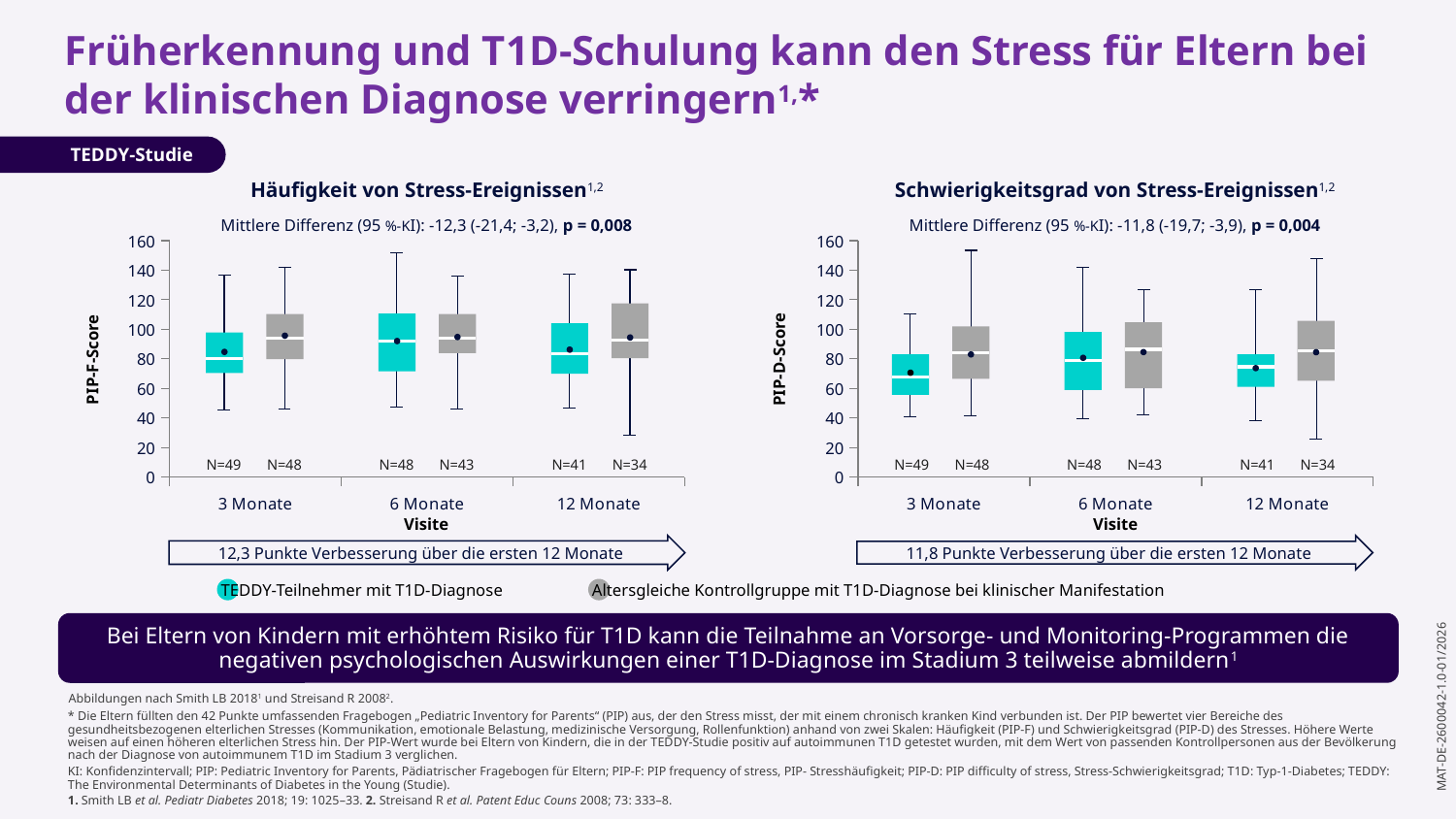
In the right chart 'Schwierigkeitsgrad von Stress-Ereignissen', what p-value is reported? p = 0,004 In the left chart 'Häufigkeit von Stress-Ereignissen', is the upper whisker of the Kontrollgruppe at 12 Monate greater or less than 120? greater In the left chart 'Häufigkeit von Stress-Ereignissen', what is the mean difference (Mittlere Differenz) with its 95% CI? -12,3 (-21,4; -3,2) In the right chart 'Schwierigkeitsgrad von Stress-Ereignissen', at 3 Monate, which group has the higher median PIP-D-Score: TEDDY-Teilnehmer or the Kontrollgruppe? Kontrollgruppe What kind of chart is used in the left chart, 'Häufigkeit von Stress-Ereignissen'? Box plot In the right chart 'Schwierigkeitsgrad von Stress-Ereignissen', what is the N for the TEDDY-Teilnehmer group at 6 Monate? N=48 In the left chart 'Häufigkeit von Stress-Ereignissen', how many visit time points are shown on the x axis? 3 In the right chart 'Schwierigkeitsgrad von Stress-Ereignissen', is the median PIP-D-Score for TEDDY-Teilnehmer at 3 Monate greater or less than 100? less How many groups does the legend below the charts list? 2 In the left chart 'Häufigkeit von Stress-Ereignissen', what is the N for the TEDDY-Teilnehmer group at 3 Monate? N=49 What is the y-axis label of the right chart 'Schwierigkeitsgrad von Stress-Ereignissen'? PIP-D-Score In the right chart 'Schwierigkeitsgrad von Stress-Ereignissen', what is the N for the Kontrollgruppe at 12 Monate? N=34